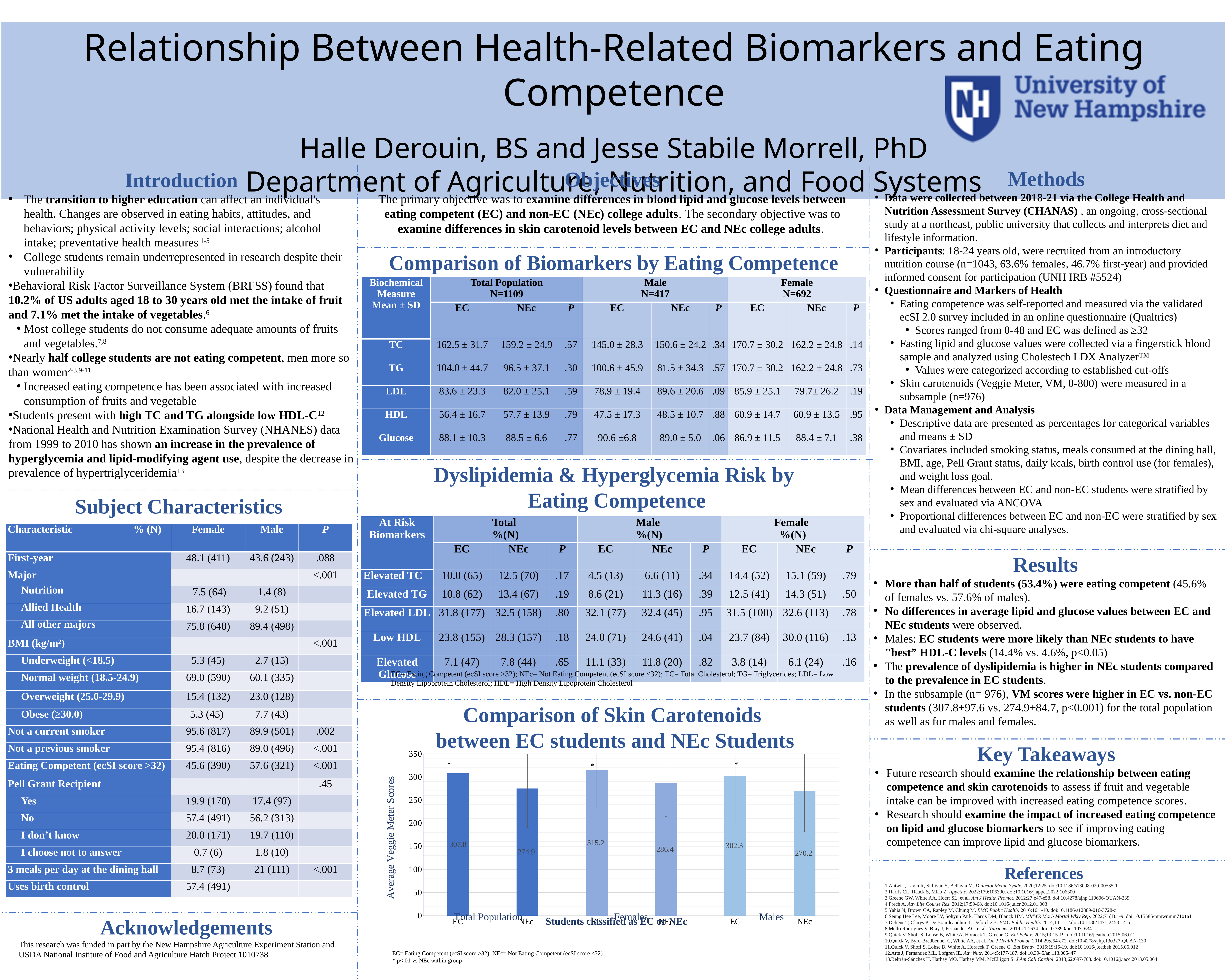
In the skin carotenoids chart, what is the difference between the EC and NEc scores for Females? 28.8 In the skin carotenoids chart, what is the average Veggie Meter score for NEc students in the Total Population? 274.9 In the skin carotenoids chart, what is the average Veggie Meter score for EC students in the Total Population? 307.8 In the skin carotenoids chart, what is the value for NEc Males? 270.2 In the skin carotenoids chart, which is larger: the score for EC Males or NEc Females? EC Males In the skin carotenoids chart, what is the value for EC Females? 315.2 In the skin carotenoids chart, which bar has the lowest average Veggie Meter score? Males NEc In the skin carotenoids chart, which bar has the highest average Veggie Meter score? Females EC What is the y-axis label of the skin carotenoids chart? Average Veggie Meter Scores How many bars are plotted in the skin carotenoids chart? 6 In the skin carotenoids chart, what is the difference between the EC and NEc scores for the Total Population? 32.9 What type of chart is used in the 'Comparison of Skin Carotenoids between EC students and NEc Students' figure? bar chart